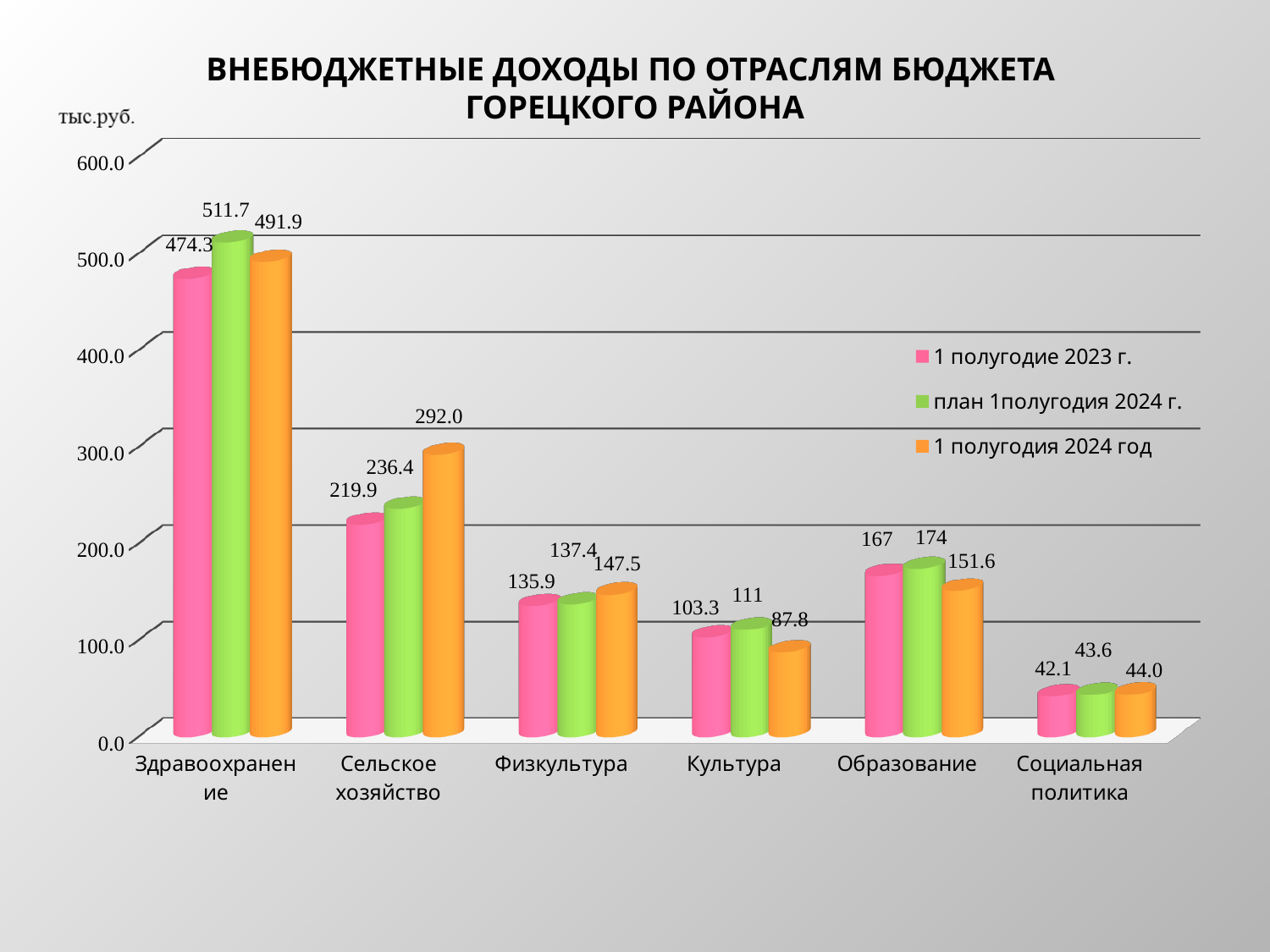
What is the value for Здравоохранение in the series 'план 1полугодия 2024 г.'? 511.7 What type of chart is shown on the slide? bar chart Is the value for Физкультура in the series '1 полугодия 2024 год' greater or less than 100.0? greater Which category has the lowest value in the series '1 полугодия 2024 год'? Социальная политика Which category has the highest value in the series '1 полугодие 2023 г.'? Здравоохранение For Образование, which is larger: the 'план 1полугодия 2024 г.' value or the '1 полугодия 2024 год' value? план 1полугодия 2024 г. What is the value for Культура in the series '1 полугодие 2023 г.'? 103.3 How many categories are shown on the x axis? 6 What is the difference between the '1 полугодия 2024 год' value and the '1 полугодие 2023 г.' value for Сельское хозяйство? 72.1 What is the value for Сельское хозяйство in the series '1 полугодия 2024 год'? 292.0 What unit is indicated at the top of the vertical axis? тыс.руб. How many series does the legend list? 3